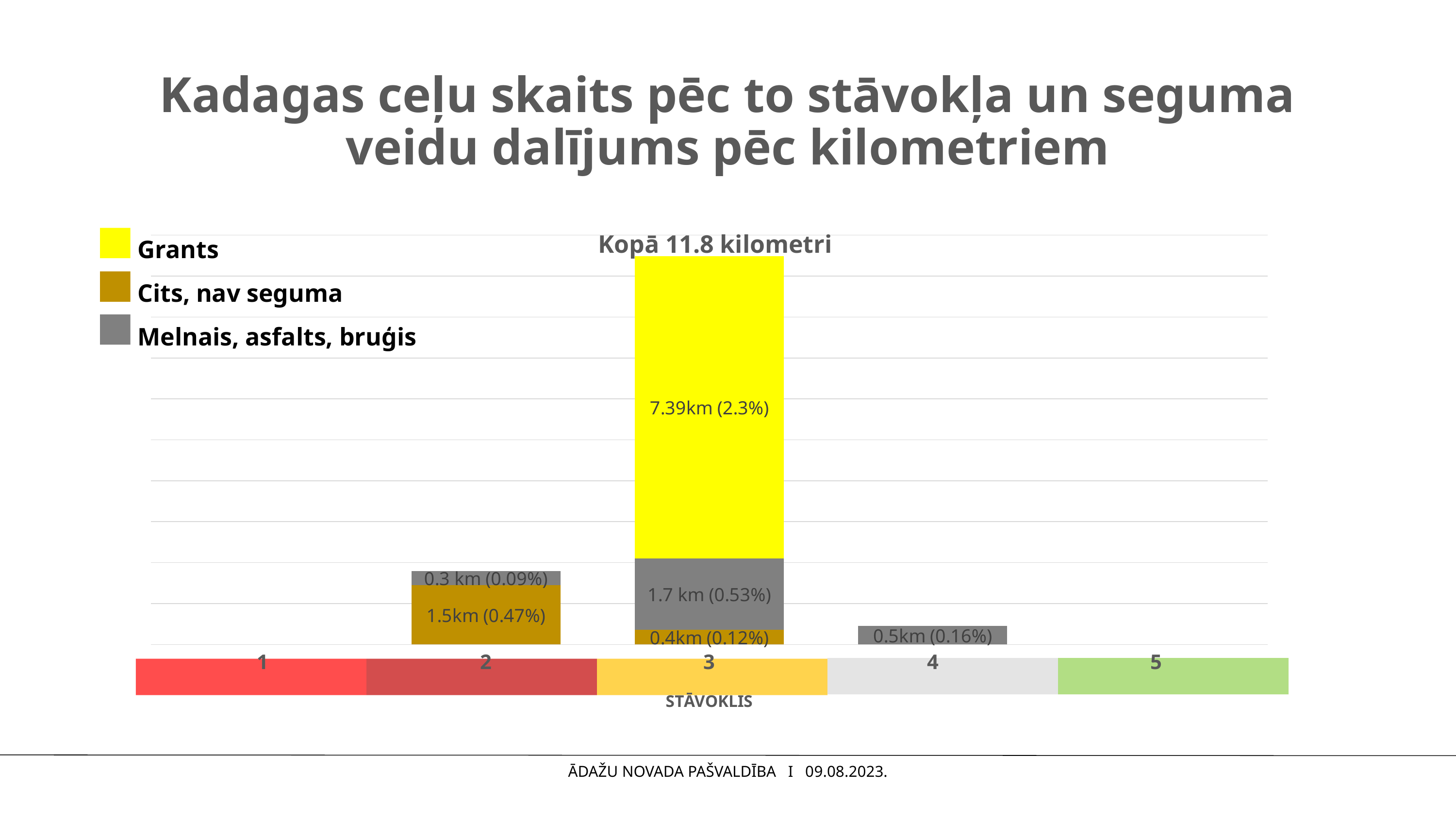
How many series does the legend list? 3 Which colour represents Grants in the legend? Yellow Which is larger: the Cits, nav seguma value in category 2 or in category 3? Category 2 (1.5km) What is the difference between the Melnais, asfalts, bruģis values in category 3 and category 2? 1.4 km What is the total length of the stacked bar for condition category 2? 1.8 km What is the Grants value for condition category 3? 7.39km (2.3%) What total length is stated above the chart? Kopā 11.8 kilometri What is the Melnais, asfalts, bruģis value for condition category 2? 0.3 km (0.09%) What kind of chart is shown on the slide? Stacked bar chart What is the Cits, nav seguma value for condition category 3? 0.4km (0.12%) What is the Melnais, asfalts, bruģis value for condition category 4? 0.5km (0.16%) Which condition category has the tallest stacked bar? 3